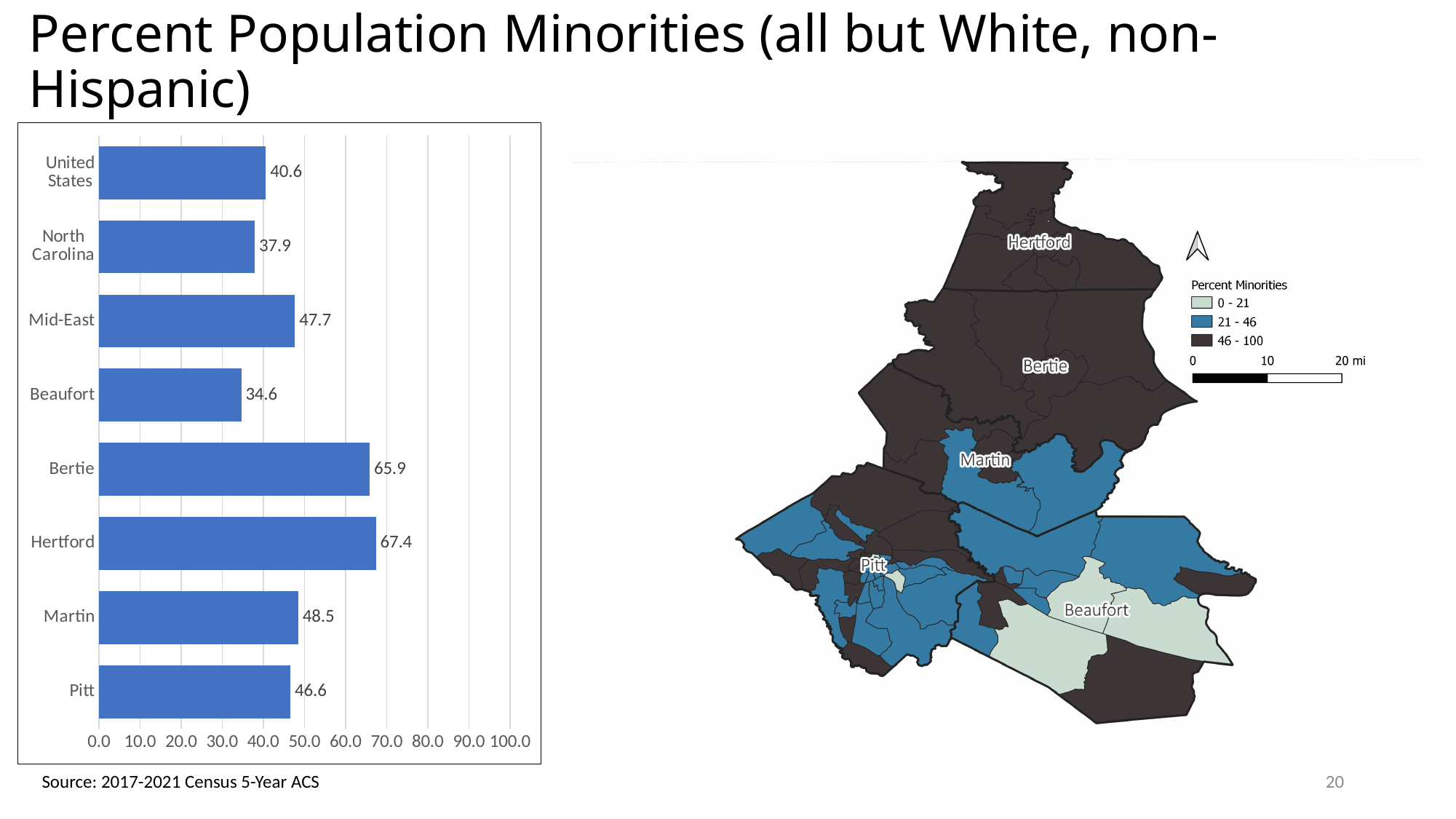
What is the value for Hertford in the bar chart? 67.4 Which category has the highest value in the bar chart? Hertford Which category has the lowest value in the bar chart? Beaufort Is the value for United States in the bar chart greater or less than 50.0? less What is the difference between the values for Bertie and Pitt in the bar chart? 19.3 What kind of chart is shown on the left of the slide? bar chart What is the difference between the values for Mid-East and United States in the bar chart? 7.1 What is the value for North Carolina in the bar chart? 37.9 What is the source cited below the bar chart? 2017-2021 Census 5-Year ACS Which is larger in the bar chart, the value for Martin or the value for Mid-East? Martin What is the value for Beaufort in the bar chart? 34.6 How many categories are shown in the bar chart? 8